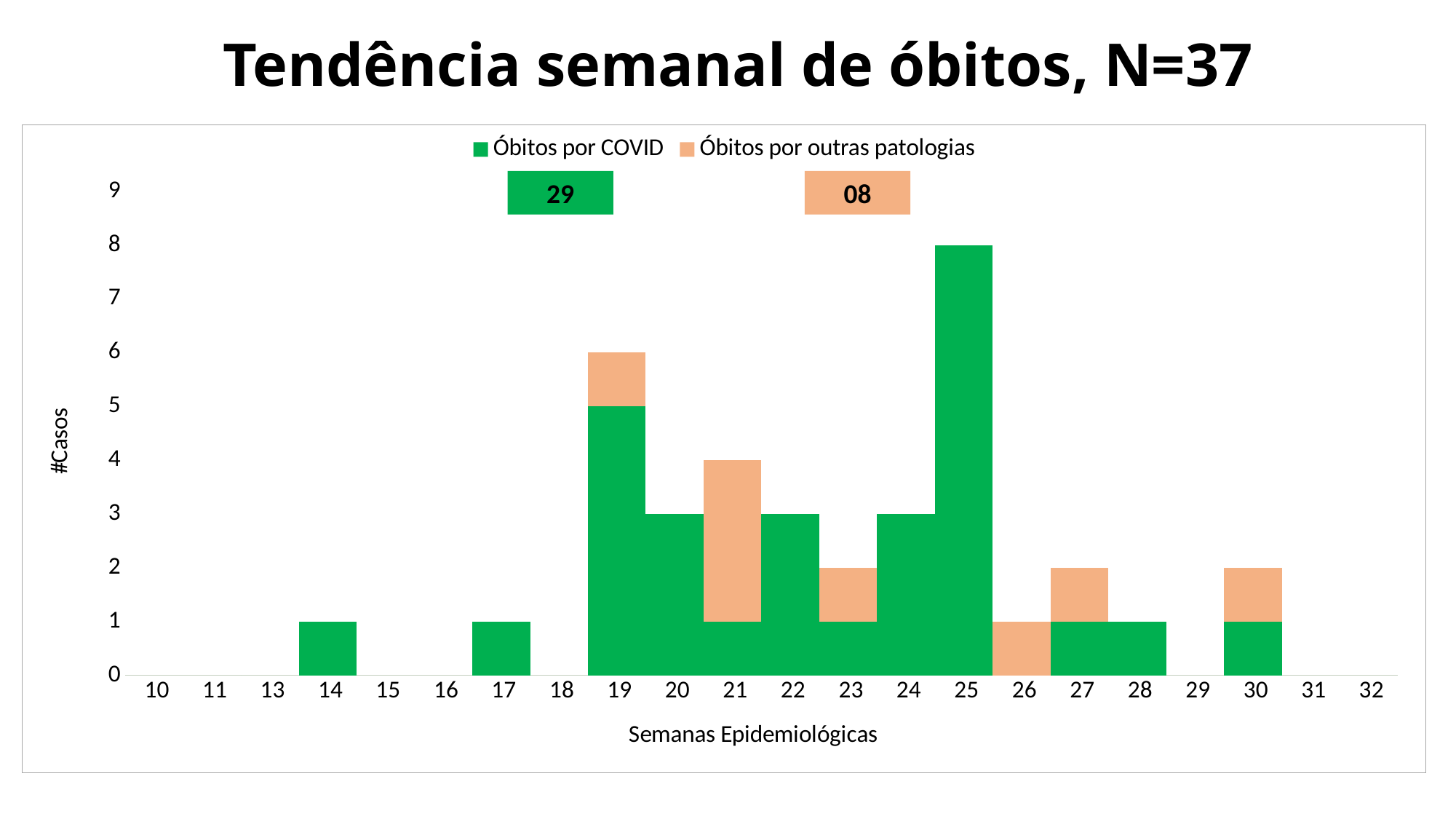
What is the title of the chart? Tendência semanal de óbitos, N=37 What type of chart is shown on the slide? stacked bar chart What is the total number of cases (both series) in week 19? 6 How many Óbitos por COVID are shown for week 25? 8 What is the total number of cases (both series) in week 21? 4 What is the difference between the Óbitos por COVID in week 25 and in week 20? 5 How many Óbitos por outras patologias are shown for week 21? 3 Which epidemiological week has the highest number of Óbitos por COVID? 25 Which is larger: the total cases in week 19 or the total cases in week 21? week 19 How many Óbitos por COVID are shown for week 19? 5 What is the total number of Óbitos por COVID shown in the green box above the chart? 29 How many series does the legend list? 2